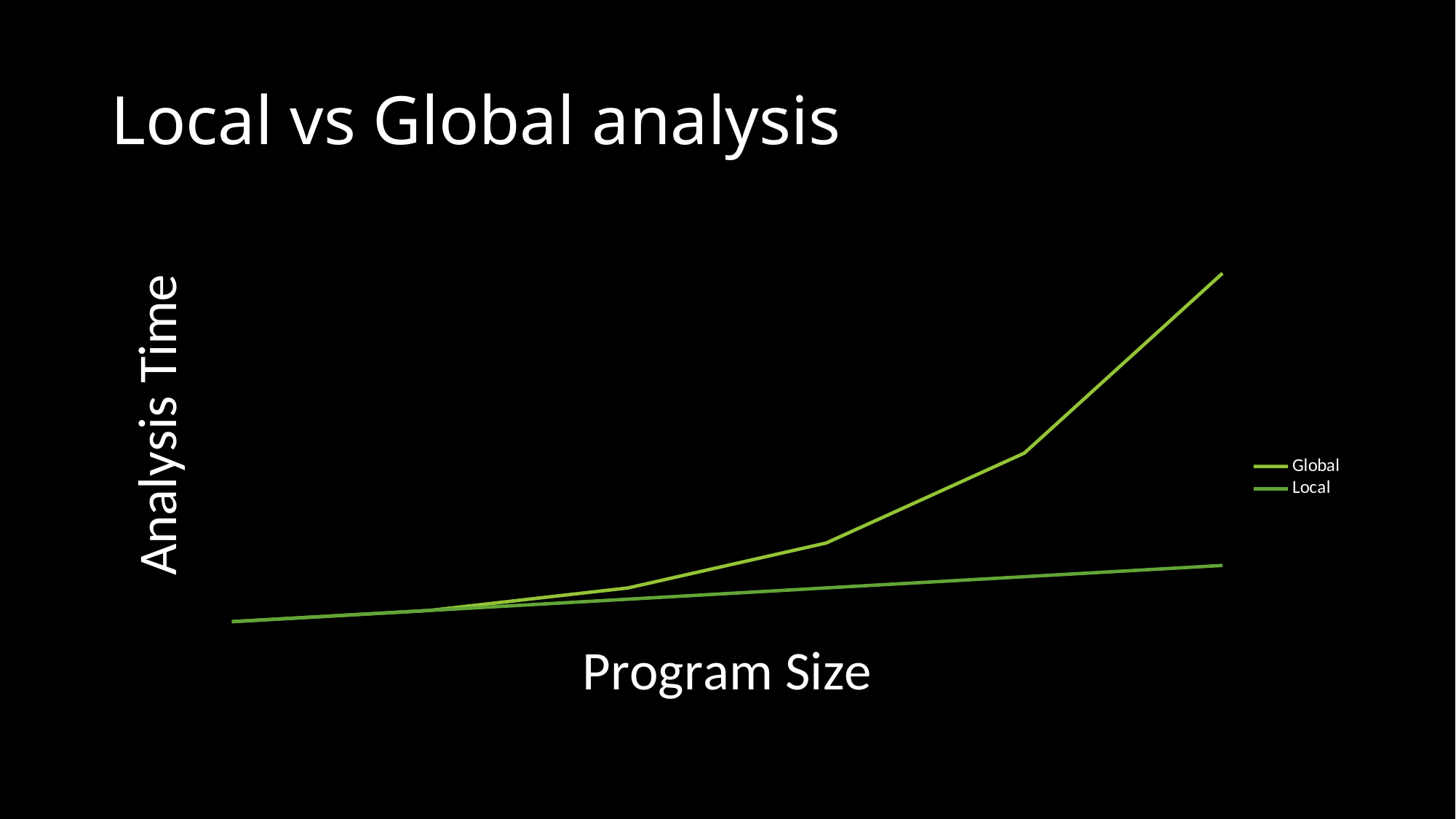
Which series reaches the highest analysis time on the chart? Global Does the Local line rise or fall as program size increases? rise Which series has the lower analysis time at the right end of the chart? Local Which series increases more steeply as program size grows, Global or Local? Global Does the Global line rise or fall as program size increases? rise What kind of chart is shown on the slide? line chart Which two series are listed in the legend? Global and Local At the largest program size, which series has the higher analysis time, Global or Local? Global How many series does the legend list? 2 How many data points does the Global line have? 6 What is the label of the vertical axis? Analysis Time